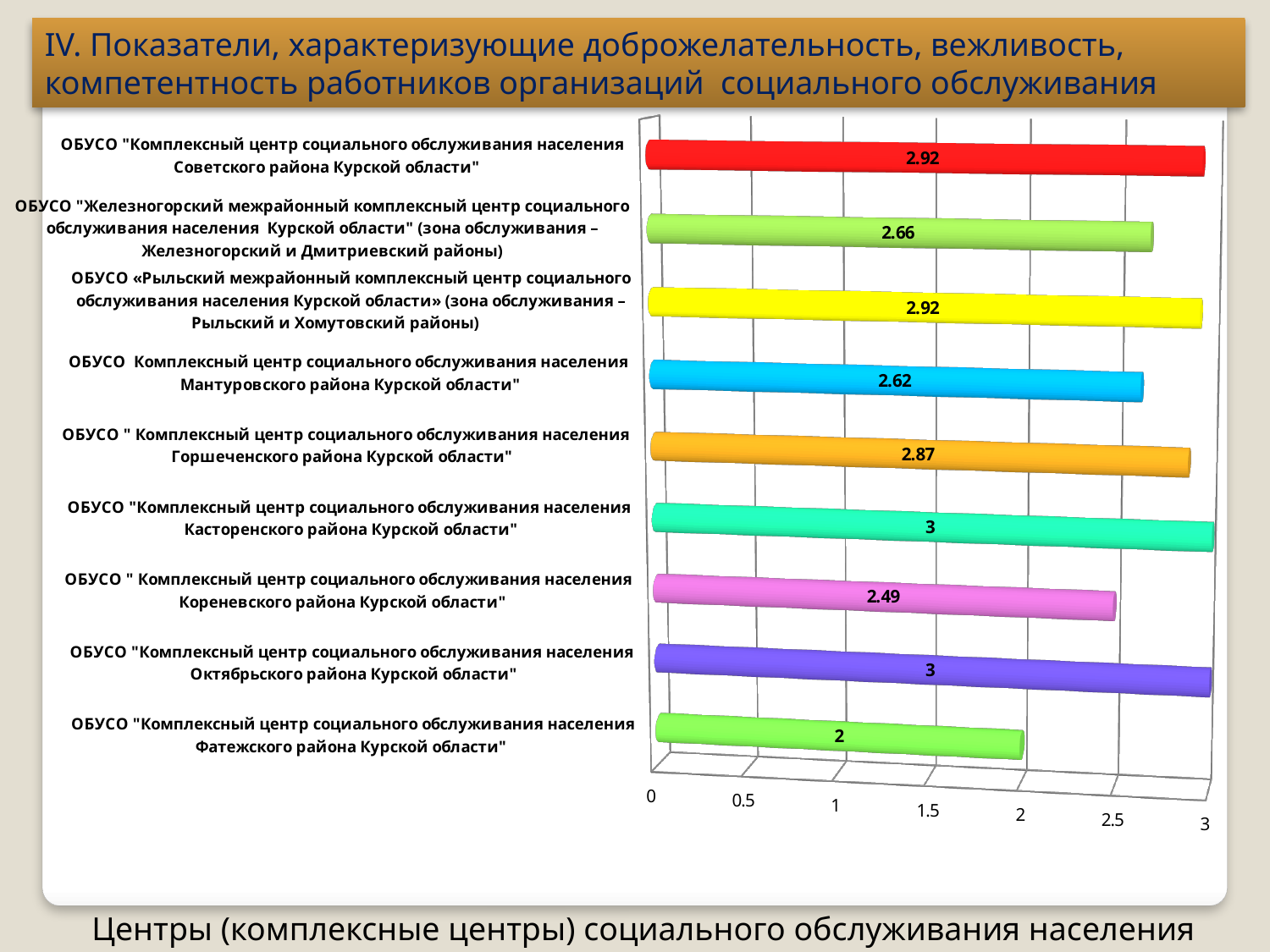
What is the value for ОБУСО "Комплексный центр социального обслуживания населения Мантуровского района Курской области"? 2.62 What is the difference between the values for the Железногорский межрайонный centre and the Кореневского района centre? 0.17 What kind of chart is shown on the slide? bar chart What is the highest value shown on the chart? 3 Which organisation has the lowest value on the chart? ОБУСО "Комплексный центр социального обслуживания населения Фатежского района Курской области" What is the difference between the values for the Касторенского района centre and the Фатежского района centre? 1 How many organisations (bars) are shown on the chart? 9 What is the value for ОБУСО "Комплексный центр социального обслуживания населения Кореневского района Курской области"? 2.49 Which has a larger value: the Горшеченского района centre or the Мантуровского района centre? Горшеченского района centre What is the value for ОБУСО "Комплексный центр социального обслуживания населения Советского района Курской области"? 2.92 What is the value for ОБУСО "Комплексный центр социального обслуживания населения Горшеченского района Курской области"? 2.87 Is the value for the Кореневского района centre greater or less than 2.5? less